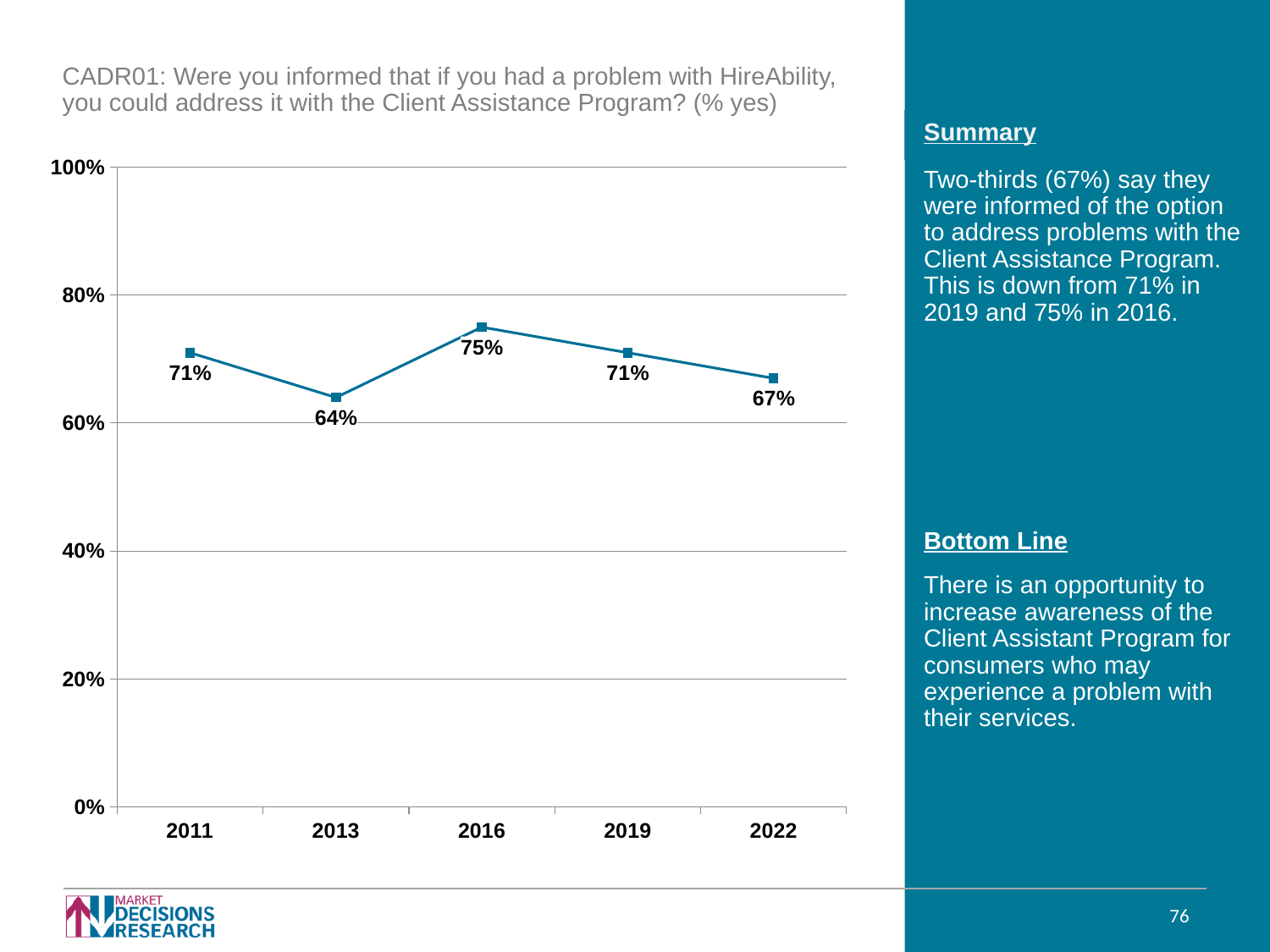
Which is larger, the value for 2013 or the value for 2022? 2022 Which year has the lowest value? 2013 What is the value for 2011? 71% What is the value for 2022? 67% What kind of chart is shown? line chart What is the difference between the values for 2016 and 2022? 8% How many years are plotted on the chart? 5 What is the value for 2013? 64% Does the value rise or fall from 2016 to 2022? fall Is the value for 2019 greater or less than 60%? greater Which year has the highest value? 2016 What is the value for 2016? 75%